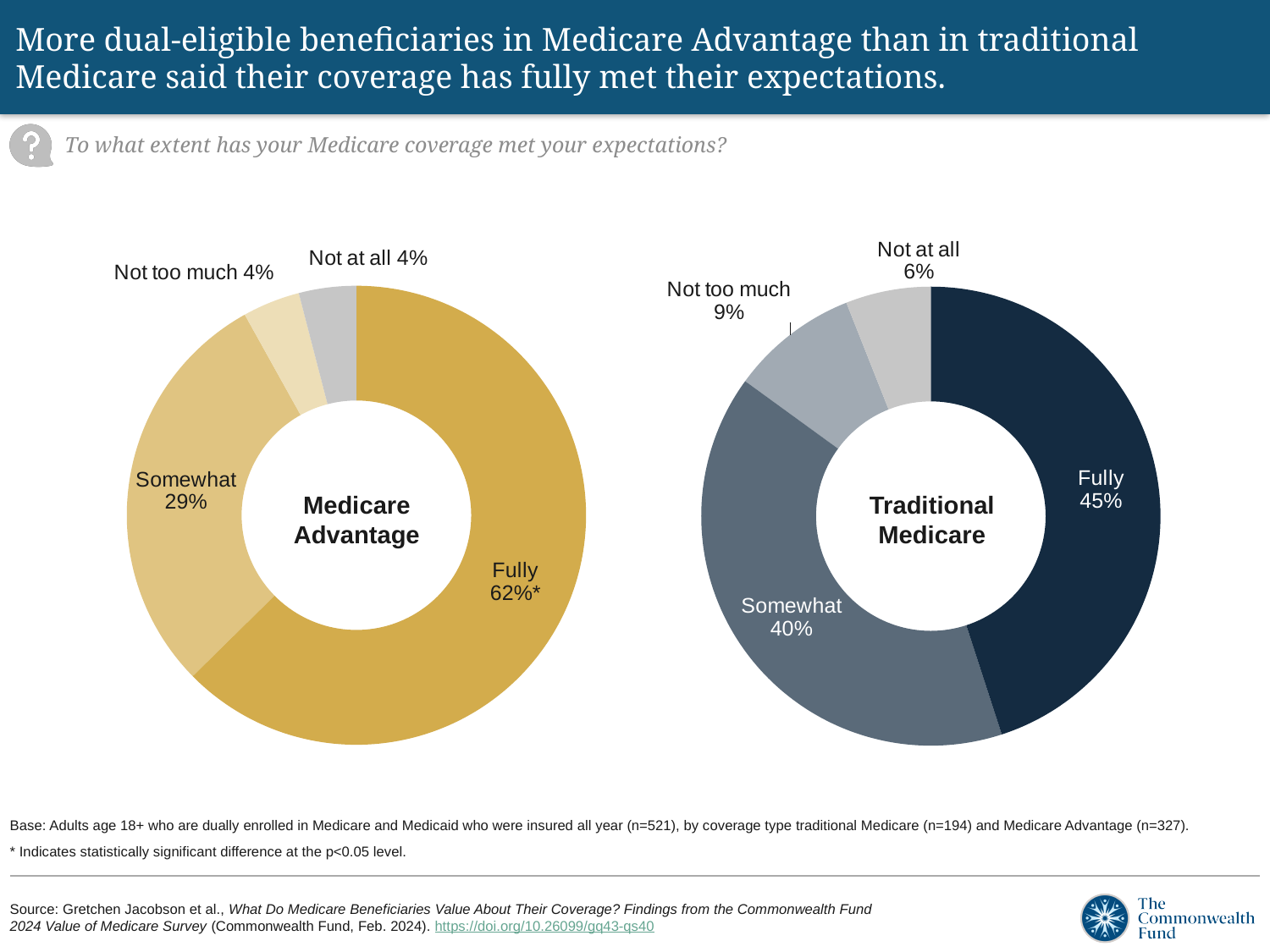
Which is larger: the 'Somewhat' share in the Traditional Medicare chart or the 'Somewhat' share in the Medicare Advantage chart? Traditional Medicare In the Traditional Medicare chart, what percentage answered 'Not at all'? 6% What type of chart is used on this slide? Donut (pie) chart In the Medicare Advantage chart, what percentage said their coverage fully met their expectations? 62% How many response categories are shown in the Traditional Medicare chart? 4 In the Medicare Advantage chart, which response has the largest share? Fully What is the combined share of 'Not too much' and 'Not at all' in the Traditional Medicare chart? 15% What is the difference between the 'Fully' share in the Medicare Advantage chart and the 'Fully' share in the Traditional Medicare chart? 17 percentage points In the Traditional Medicare chart, what percentage said their coverage fully met their expectations? 45% In the Medicare Advantage chart, what percentage answered 'Not too much'? 4% In the Traditional Medicare chart, which response has the smallest share? Not at all In the Traditional Medicare chart, what percentage answered 'Somewhat'? 40%